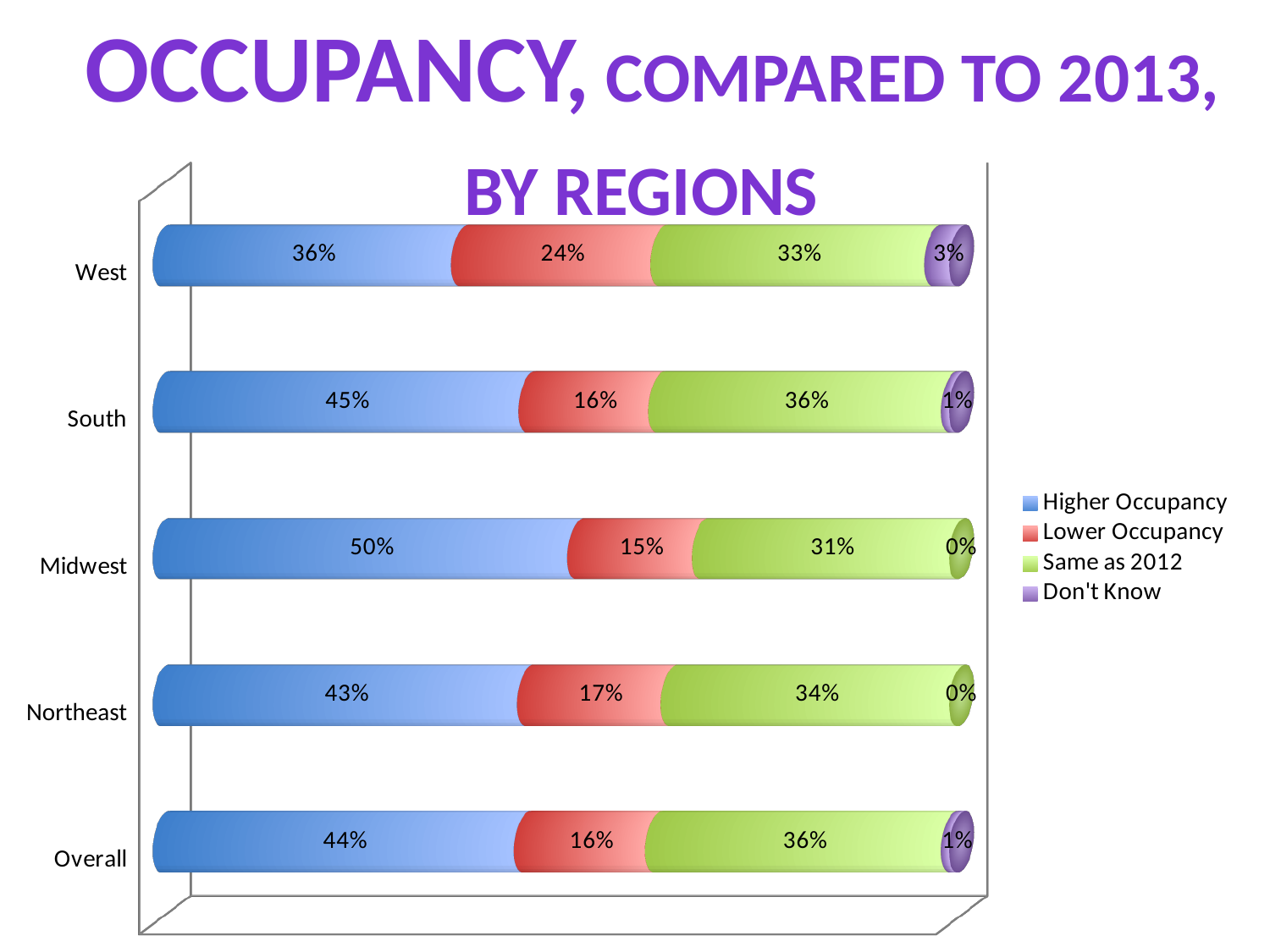
What is the Higher Occupancy value for the Midwest? 50% Which colour represents the Same as 2012 series? Green How many series does the legend list? 4 What is the Don't Know value for the West? 3% What is the difference between the Higher Occupancy values for the South and the West? 9% Which region has the lowest Higher Occupancy value? West What kind of chart is shown on the slide? Stacked bar chart How many regions (categories) are shown on the chart? 5 Which region has the highest Higher Occupancy value? Midwest Which is larger, the Lower Occupancy value for the West or for the Midwest? West What is the Lower Occupancy value for the West? 24% What is the Same as 2012 value for the Northeast? 34%